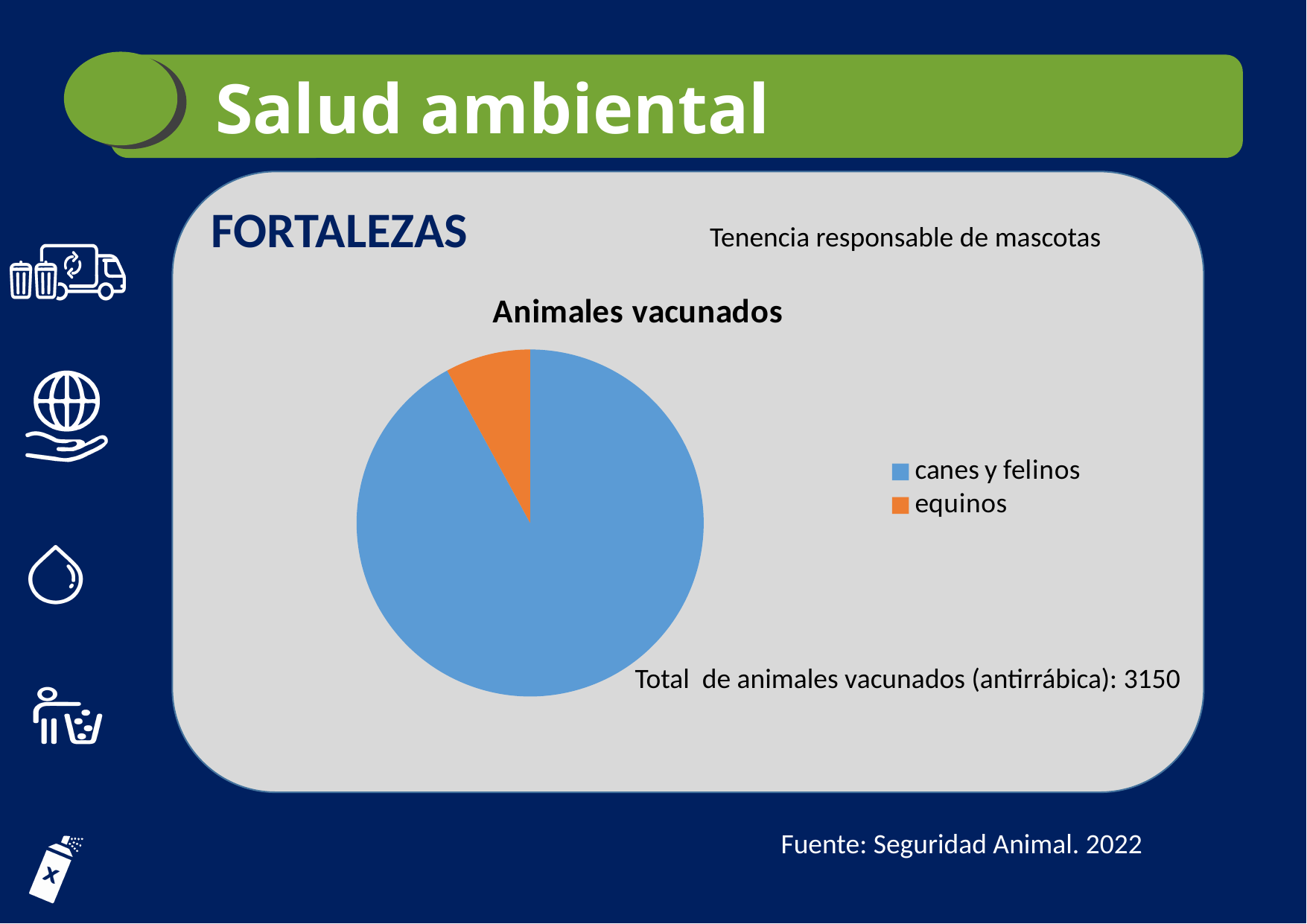
Which is larger, the slice for canes y felinos or the slice for equinos? canes y felinos What kind of chart is shown on the slide? pie chart How many entries does the chart legend list? 2 What colour is the slice for equinos? orange Which category has the smallest slice of the pie? equinos How many slices does the pie chart have? 2 Which category has the largest slice of the pie? canes y felinos What is the title of the chart? Animales vacunados According to the text next to the chart, what is the total number of animals vaccinated (antirrábica)? 3150